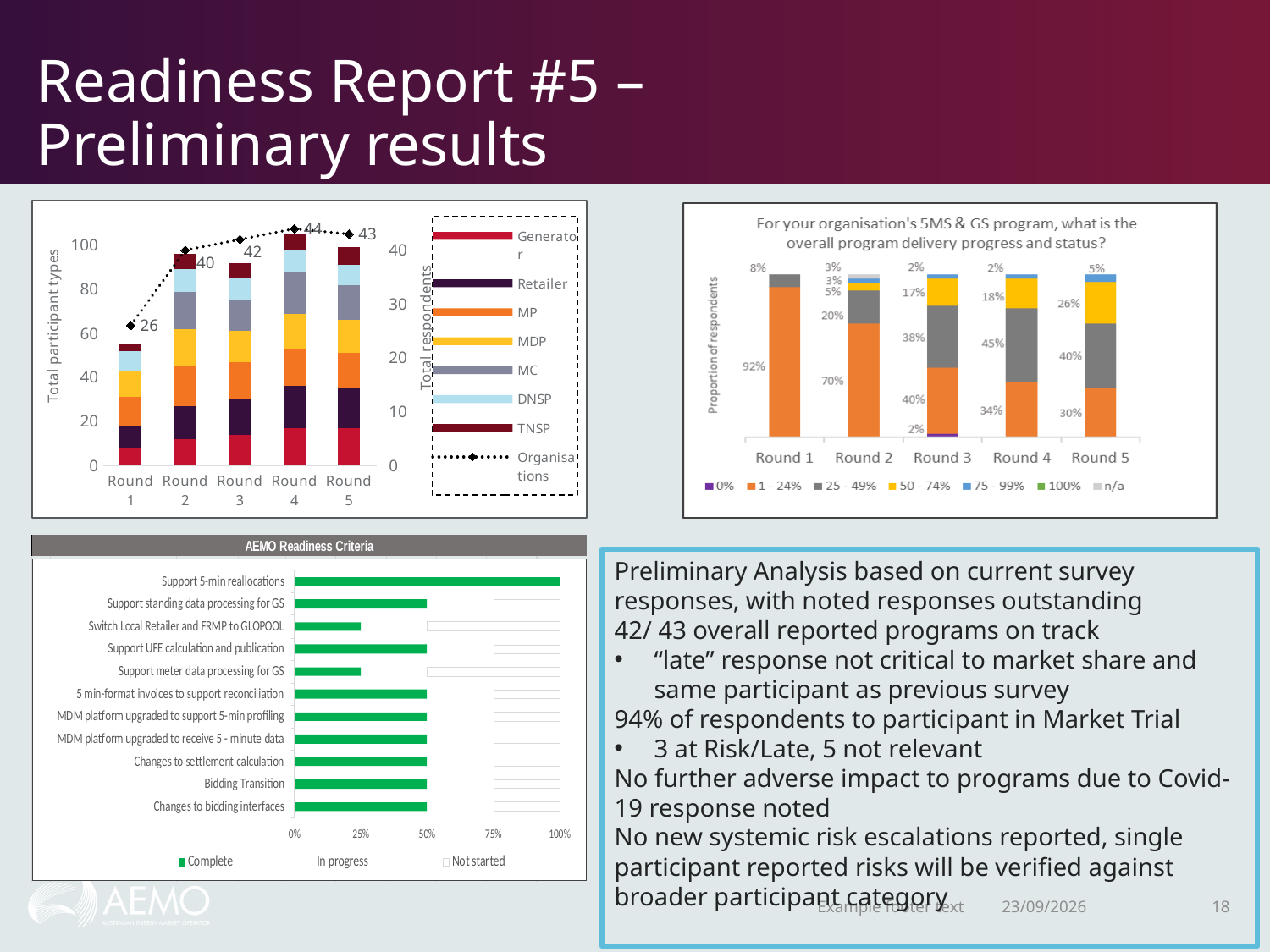
In the top-left chart, what is the difference between the Organisations values for Round 4 and Round 1? 18 What kind of chart is the 'AEMO Readiness Criteria' chart? bar chart In the chart titled 'For your organisation's 5MS & GS program, what is the overall program delivery progress and status?', what is the 1 - 24% value for Round 1? 92% In the chart titled 'For your organisation's 5MS & GS program, what is the overall program delivery progress and status?', what is the 50 - 74% value for Round 5? 26% How many rounds are shown on the x axis of the chart titled 'For your organisation's 5MS & GS program, what is the overall program delivery progress and status?'? 5 In the chart titled 'For your organisation's 5MS & GS program, what is the overall program delivery progress and status?', which is larger, the 25 - 49% value for Round 4 or for Round 5? Round 4 In the top-left chart, which round has the highest Organisations value? Round 4 How many criteria are listed in the 'AEMO Readiness Criteria' chart? 11 How many entries does the legend of the top-left chart list? 8 How many entries does the legend of the chart titled 'For your organisation's 5MS & GS program, what is the overall program delivery progress and status?' list? 7 In the chart titled 'For your organisation's 5MS & GS program, what is the overall program delivery progress and status?', what is the 25 - 49% value for Round 3? 38% In the top-left chart, what is the Organisations value for Round 1? 26